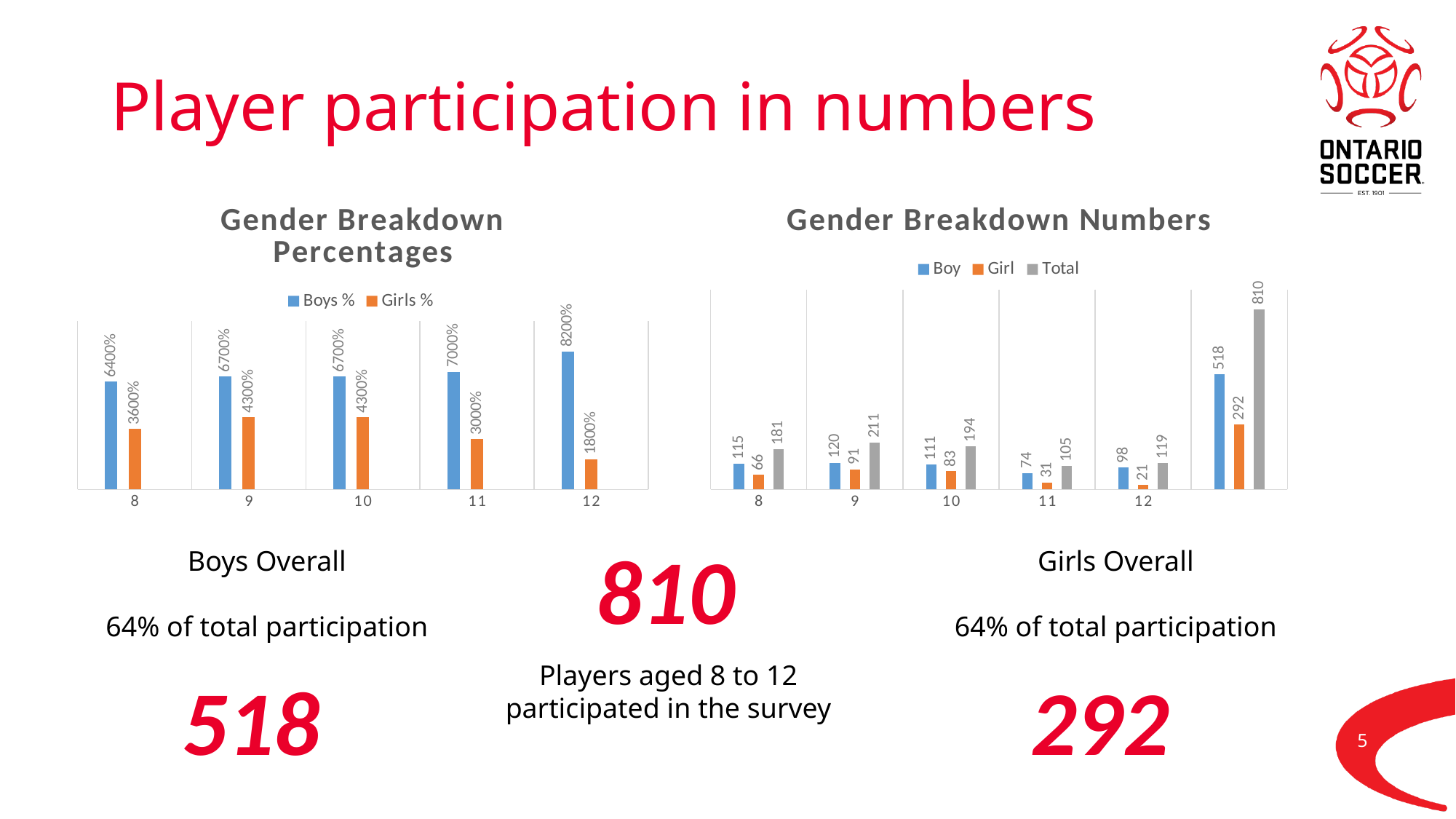
What type of chart is the Gender Breakdown Percentages chart? bar chart In the Gender Breakdown Percentages chart, what colour are the Girls % bars? orange In the Gender Breakdown Percentages chart, which age has the highest Boys % value? 12 How many series does the legend of the Gender Breakdown Numbers chart list? 3 In the Gender Breakdown Percentages chart, what is the Boys % value for age 12? 8200% In the Gender Breakdown Percentages chart, what is the Girls % value for age 8? 3600% In the Gender Breakdown Numbers chart, what is the difference between the Boy and Girl values for age 11? 43 In the Gender Breakdown Percentages chart, which age has the lowest Girls % value? 12 In the Gender Breakdown Numbers chart, is the Boy value for age 8 larger or the Boy value for age 12? age 8 In the Gender Breakdown Numbers chart, what is the Total value for age 10? 194 In the Gender Breakdown Numbers chart, what is the Girl value for age 9? 91 In the Gender Breakdown Numbers chart, which age from 8 to 12 has the lowest Total value? 11